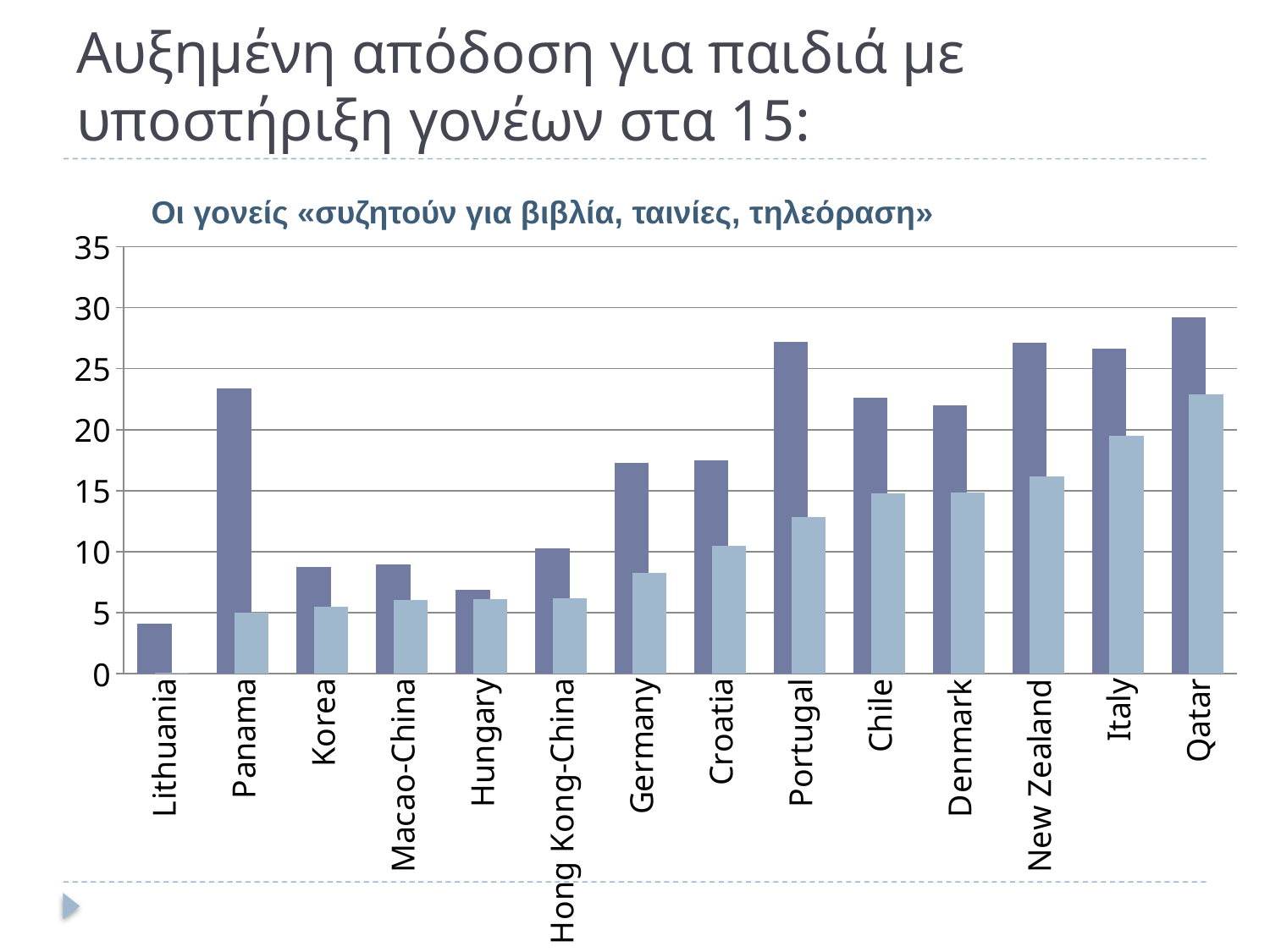
Is the dark blue bar for Lithuania greater or less than 5? less Which country has the shortest dark blue bar? Lithuania Which country has the tallest light blue bar? Qatar Is the light blue bar for Portugal greater or less than 10? greater What is the title of the chart? Οι γονείς «συζητούν για βιβλία, ταινίες, τηλεόραση» Is the dark blue bar for Qatar greater or less than 25? greater How many countries are shown on the x axis of the chart? 14 Which has the taller dark blue bar, Panama or Korea? Panama What kind of chart is shown on the slide? bar chart Which has the taller dark blue bar, Portugal or Chile? Portugal Which country has the tallest dark blue bar? Qatar